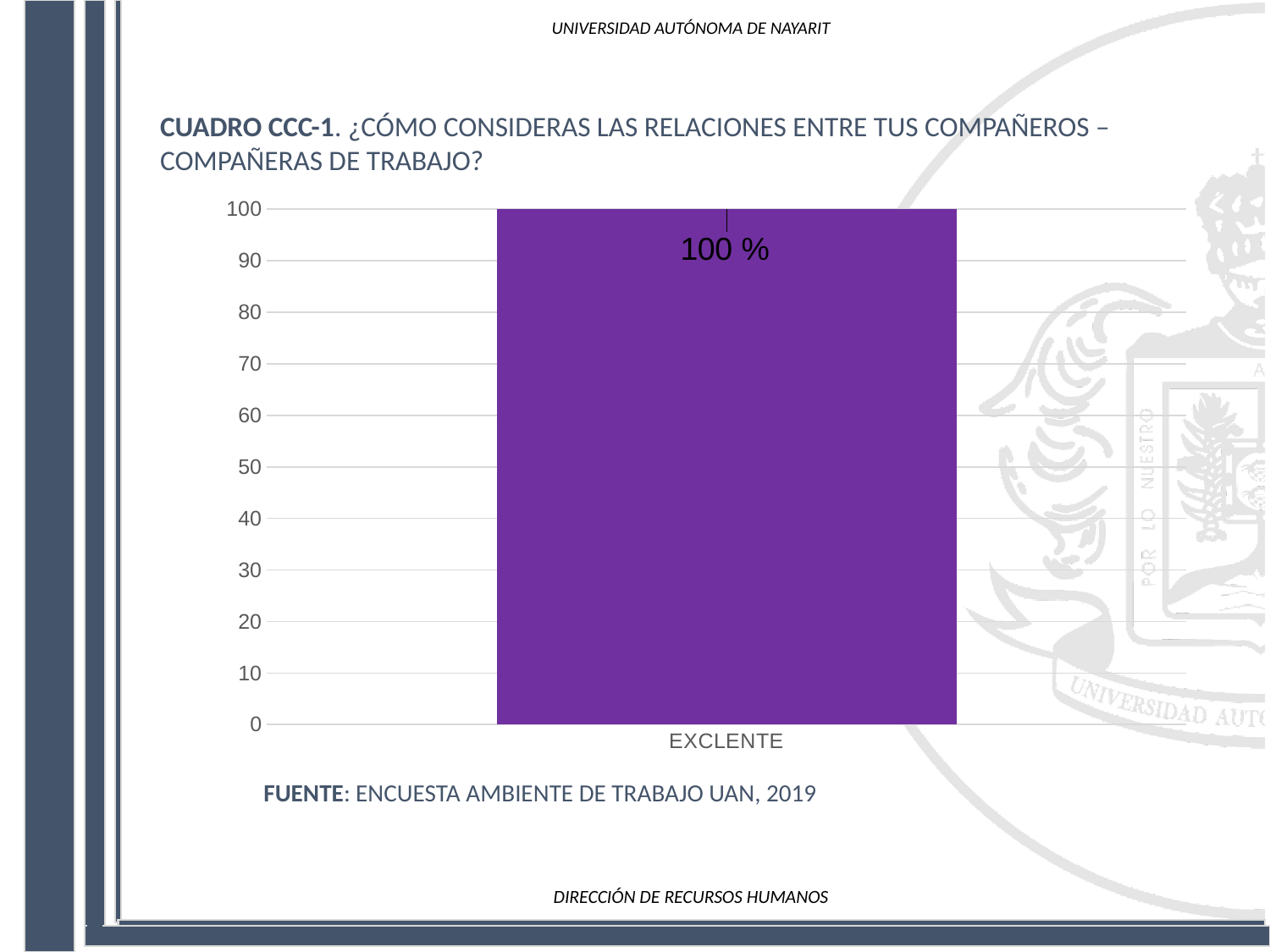
Which category has the highest value in the chart? EXCLENTE How many categories are plotted on the x axis of the chart? 1 What is the maximum value shown on the y axis of the chart? 100 What is the label of the only category on the x axis? EXCLENTE Is the value for EXCLENTE greater or less than 50? greater What is the value shown for the EXCLENTE category? 100 % What kind of chart is shown on the slide? bar chart